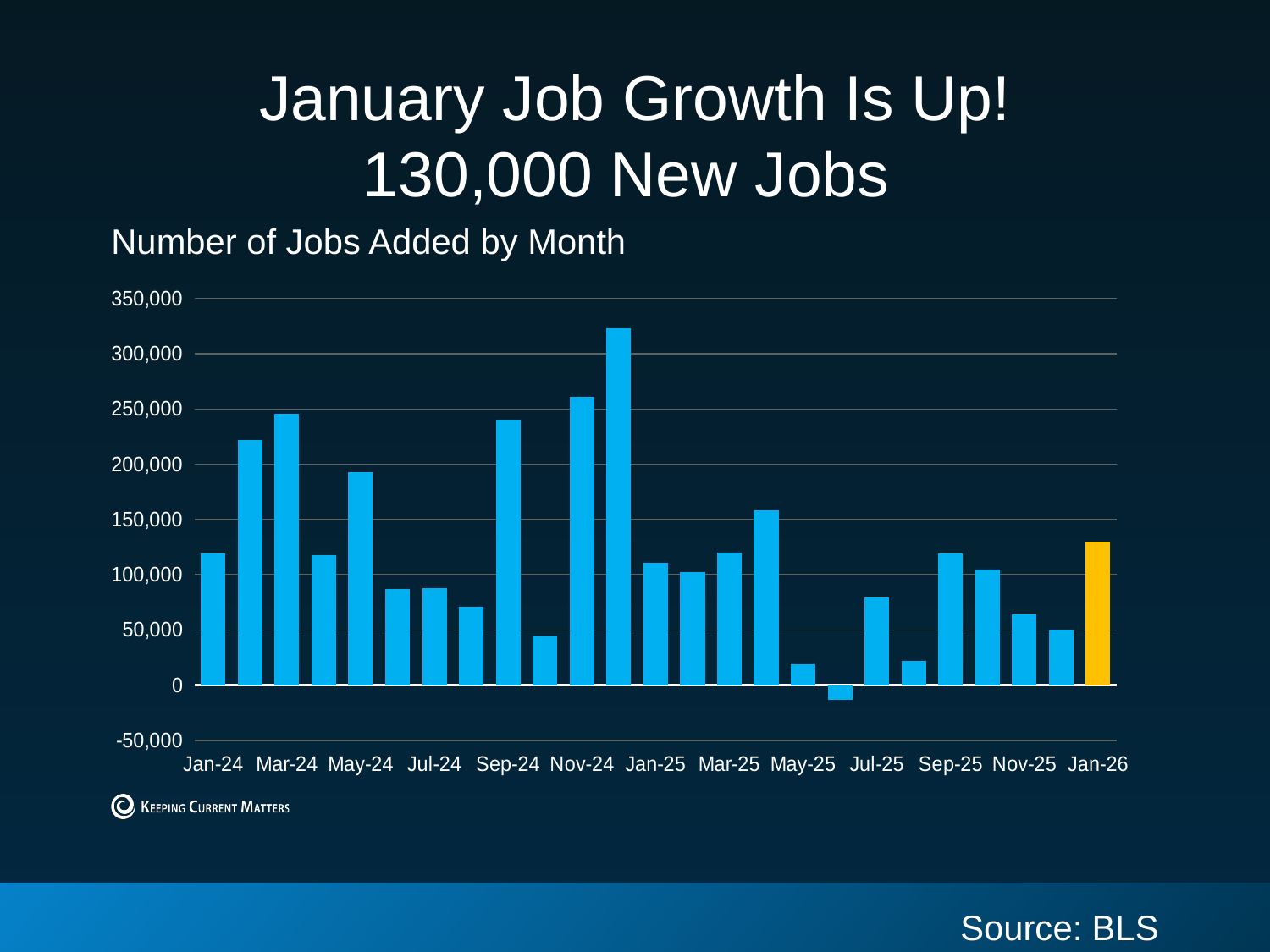
Is the value for May-25 greater or less than 50,000? less Is the value for Sep-24 greater or less than 200,000? greater What kind of chart is shown on the slide? Bar chart What is the value for Jan-26 in the Number of Jobs Added by Month chart? 130,000 How many bars in the chart fall below zero? 1 Is the value for Jul-25 greater or less than 100,000? less Which is larger, the value for Mar-24 or the value for Jan-26? Mar-24 What colour is the Jan-26 bar, which differs from the other bars? Yellow How many monthly bars are plotted in the chart? 25